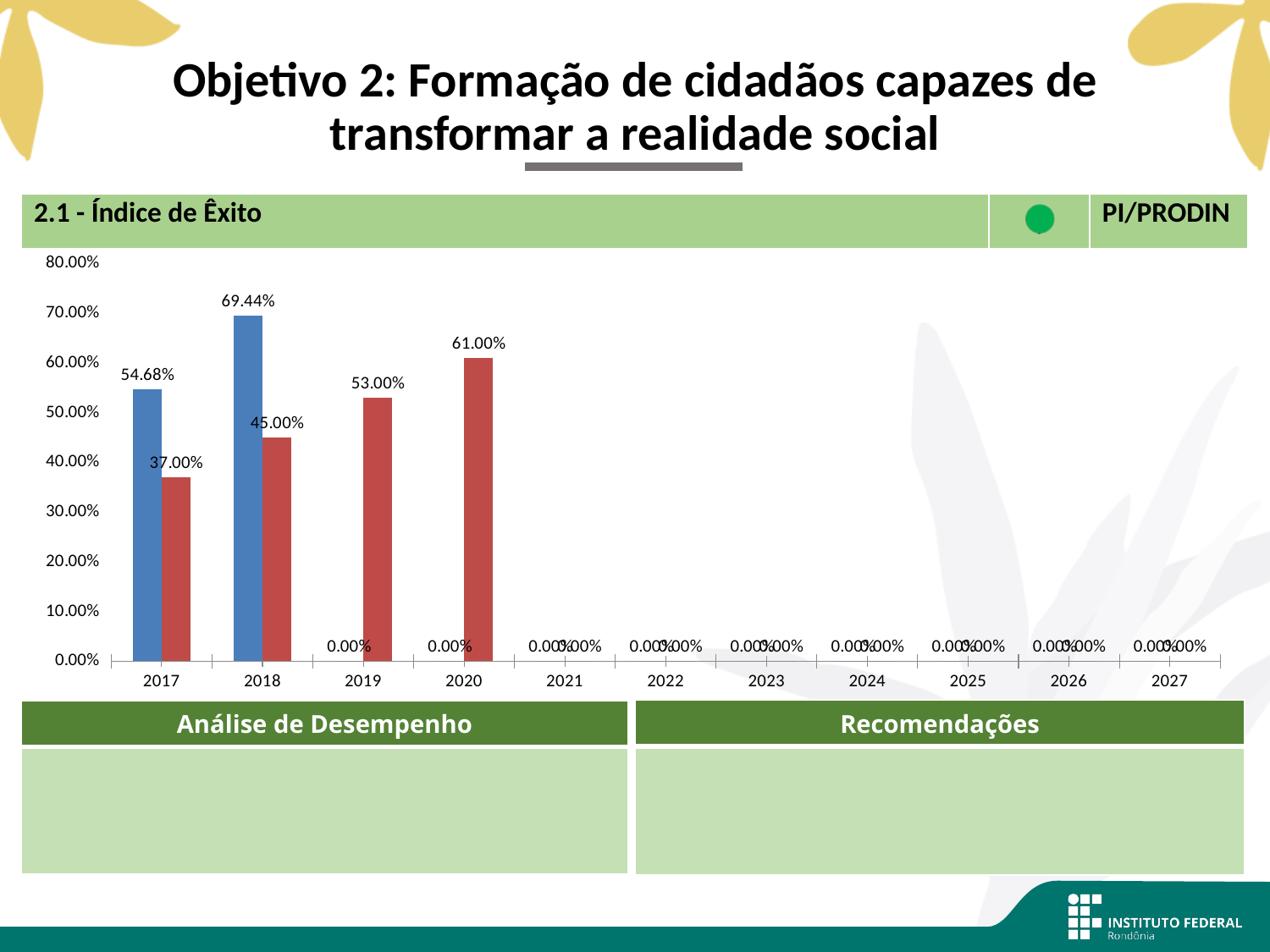
Which is larger in 2018, the blue bar or the red bar? The blue bar Do the red bar values rise or fall from 2017 to 2020? Rise What is the value of the blue bar for 2018? 69.44% What is the difference between the blue bar and the red bar in 2017? 17.68% What is the value of the red bar for 2020? 61.00% What kind of chart is shown on the slide? Bar chart What is the value of the blue bar for 2017? 54.68% What is the difference between the red bar values for 2020 and 2019? 8.00% Which year has the highest blue bar? 2018 How many years are shown on the x axis? 11 What is the value of the red bar for 2019? 53.00% Which year has the highest red bar? 2020